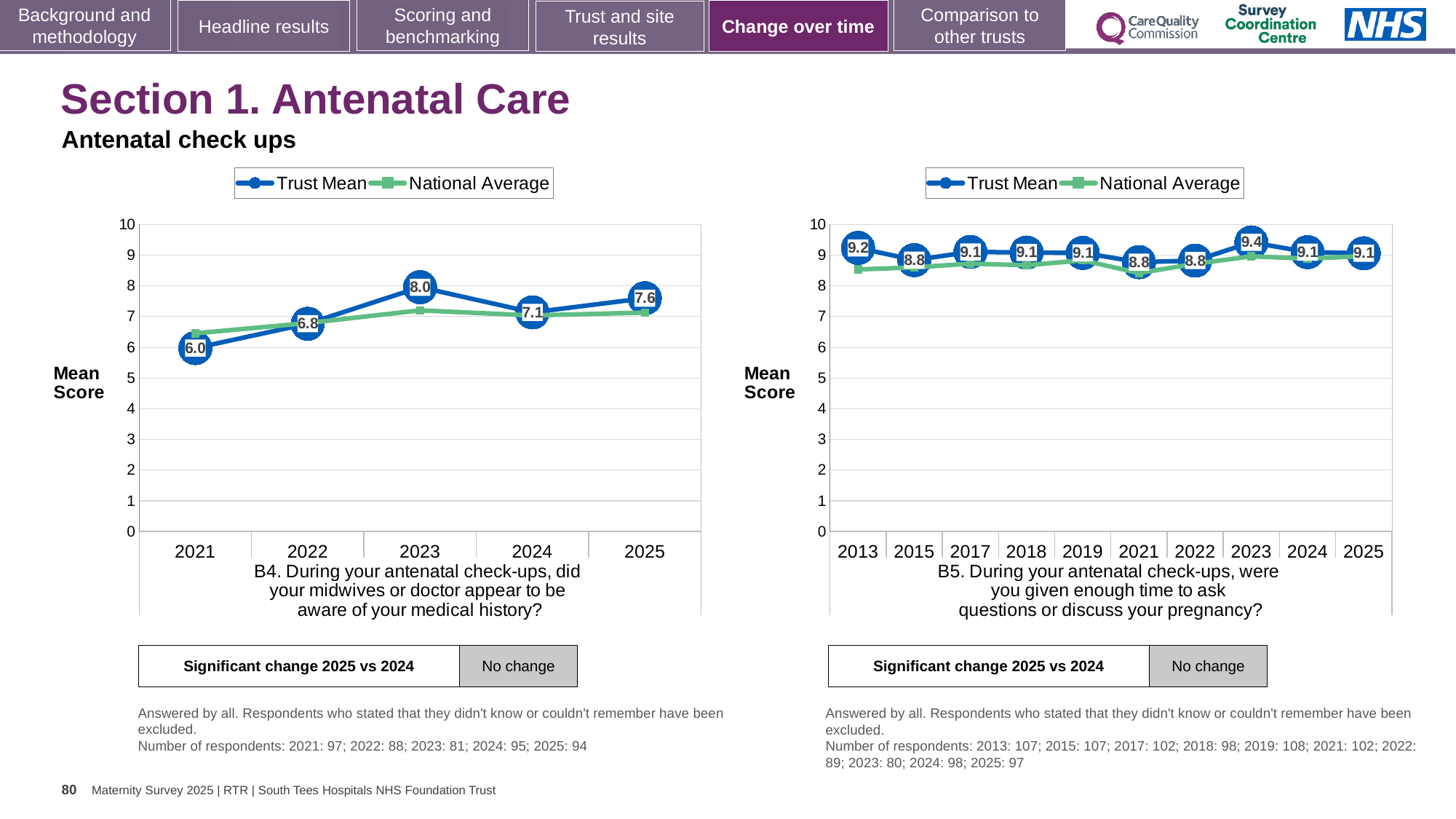
On the left chart (B4), is the National Average for 2021 greater or less than 6? greater On the right chart (B5), which year has the highest Trust Mean? 2023 On the left chart (B4), what is the Trust Mean for 2021? 6.0 On the right chart (B5), how many years are shown on the x axis? 10 On the left chart (B4), what is the Trust Mean for 2023? 8.0 On the left chart (B4), how many years are shown on the x axis? 5 On the right chart (B5), what is the Trust Mean for 2023? 9.4 On the right chart (B5), how many series does the legend list? 2 On the left chart (B4), which year has the lowest Trust Mean? 2021 On the left chart (B4), which year has the highest Trust Mean? 2023 What type of chart is the left chart (B4)? Line chart On the left chart (B4), what is the difference between the Trust Mean for 2025 and 2024? 0.5